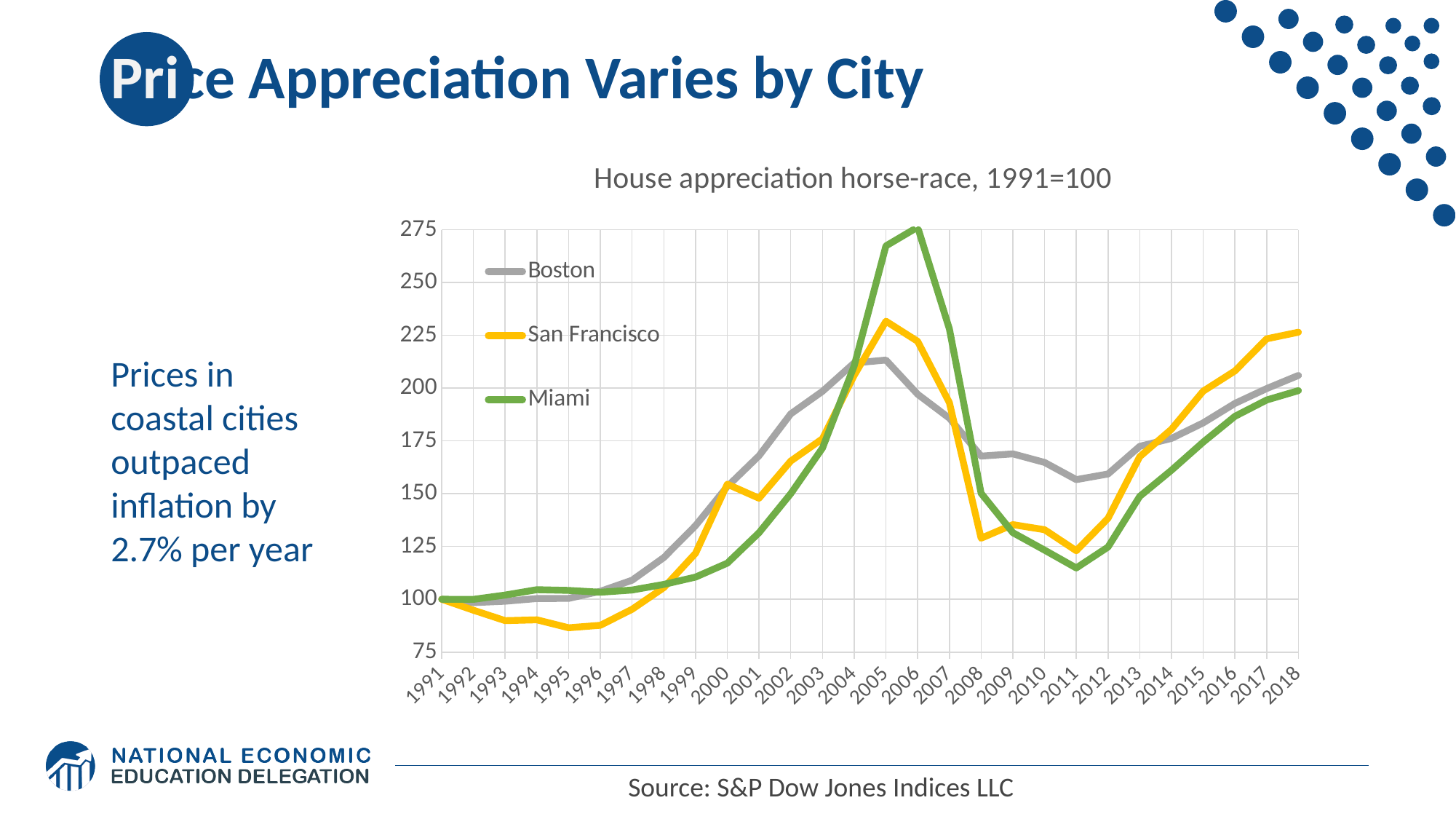
Is the value for San Francisco in 1995 greater or less than 100? less Which is larger in 2018, the value for San Francisco or the value for Miami? San Francisco What is the title of the chart? House appreciation horse-race, 1991=100 What kind of chart is shown on the slide? Line chart Is the value for Boston in 2011 greater or less than 175? less How many years are shown along the x axis? 28 Which is larger in 2000, the value for Boston or the value for Miami? Boston In which year does the Miami line reach its peak? 2006 Which city reaches the highest value on the chart? Miami How many series does the legend list? 3 Is the value for Miami in 2006 greater or less than 250? greater Does the Boston line rise or fall between 2005 and 2011? Fall